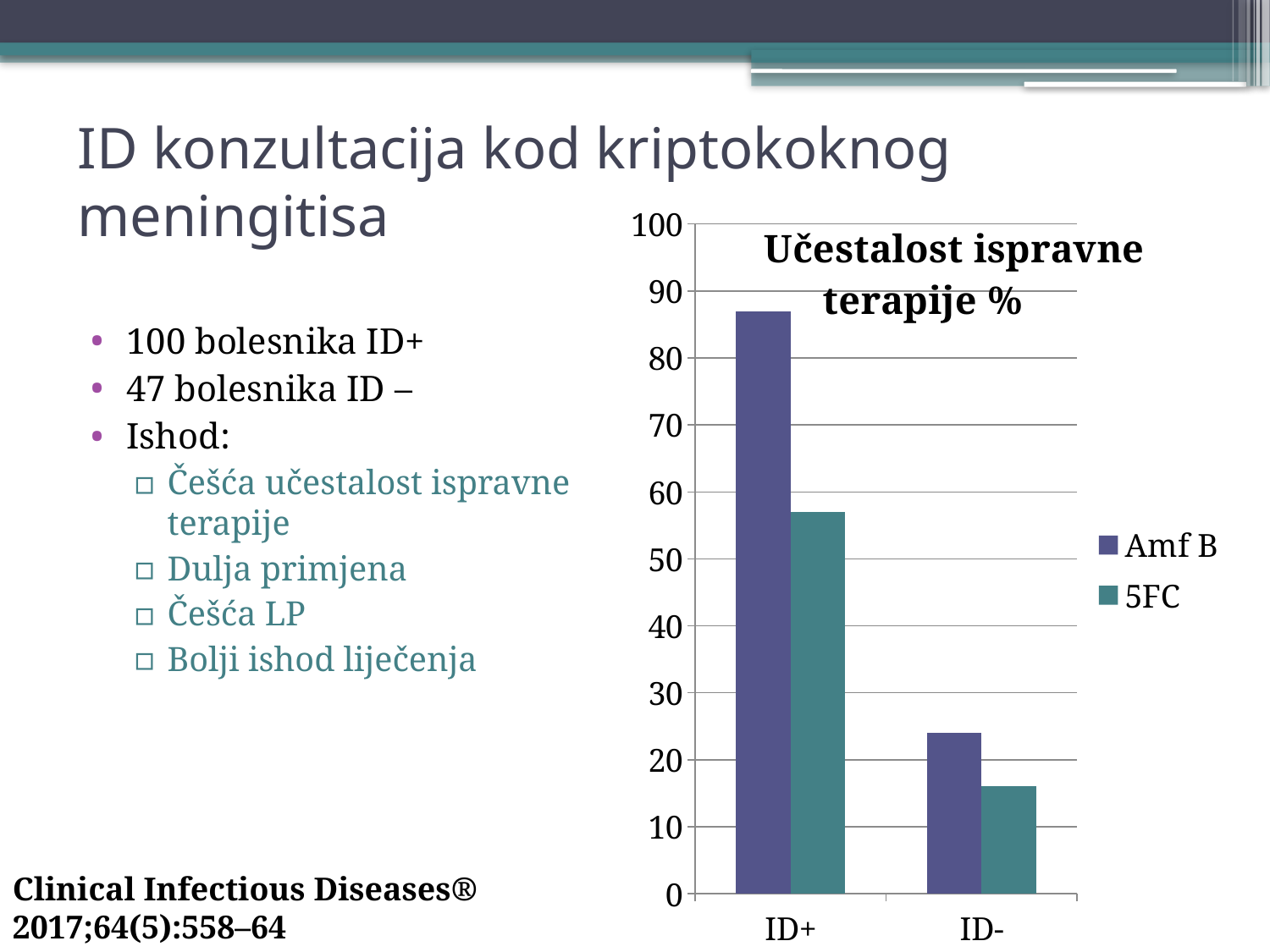
Is the Amf B value for ID- greater or less than 30? less For the ID+ category, which series has the larger value, Amf B or 5FC? Amf B Is the 5FC value for ID+ greater or less than 60? less Is the Amf B value for ID+ greater or less than 80? greater What is the title of the chart? Učestalost ispravne terapije % How many series does the chart legend list? 2 What kind of chart is shown on the slide? bar chart How many categories are shown on the x axis of the chart? 2 Which category has the lowest 5FC value? ID- Which category has the highest Amf B value? ID+ What are the two series named in the chart legend? Amf B and 5FC